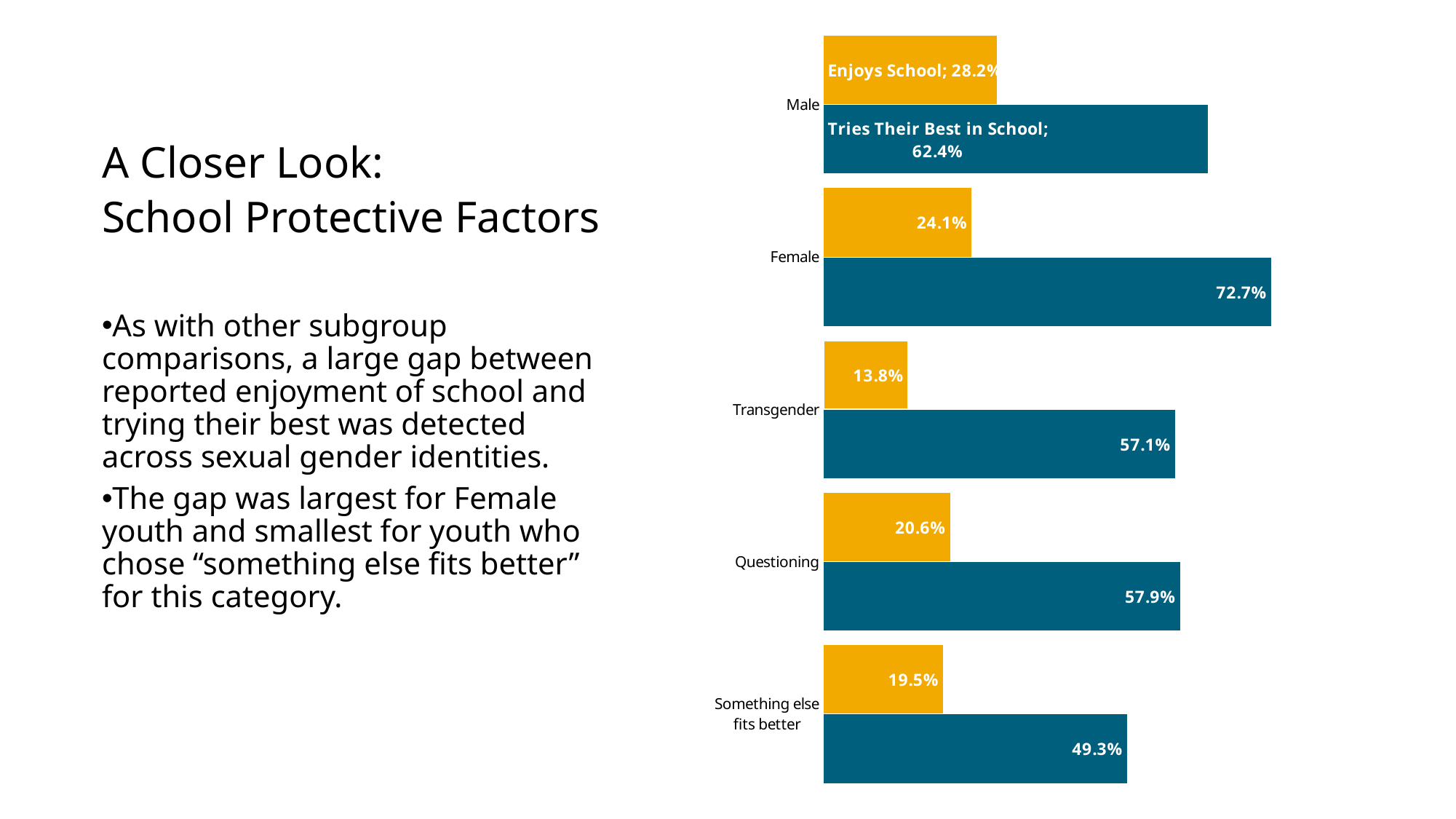
Which group has the highest value for Tries Their Best in School? Female What is the difference between Tries Their Best in School and Enjoys School for youth who chose Something else fits better? 29.8% What percentage of Transgender youth report enjoying school? 13.8% Which group has the lowest value for Enjoys School? Transgender What type of chart is shown on the slide? Bar chart What is the value for Female youth in the Tries Their Best in School series? 72.7% What is the Tries Their Best in School value for youth who chose Something else fits better? 49.3% How many gender identity groups are shown on the chart? 5 Which is larger: the Enjoys School value for Male youth or for Questioning youth? Male What is the difference between Tries Their Best in School and Enjoys School for Female youth? 48.6% How many data series does the chart show? 2 What percentage of Male youth report that they enjoy school? 28.2%